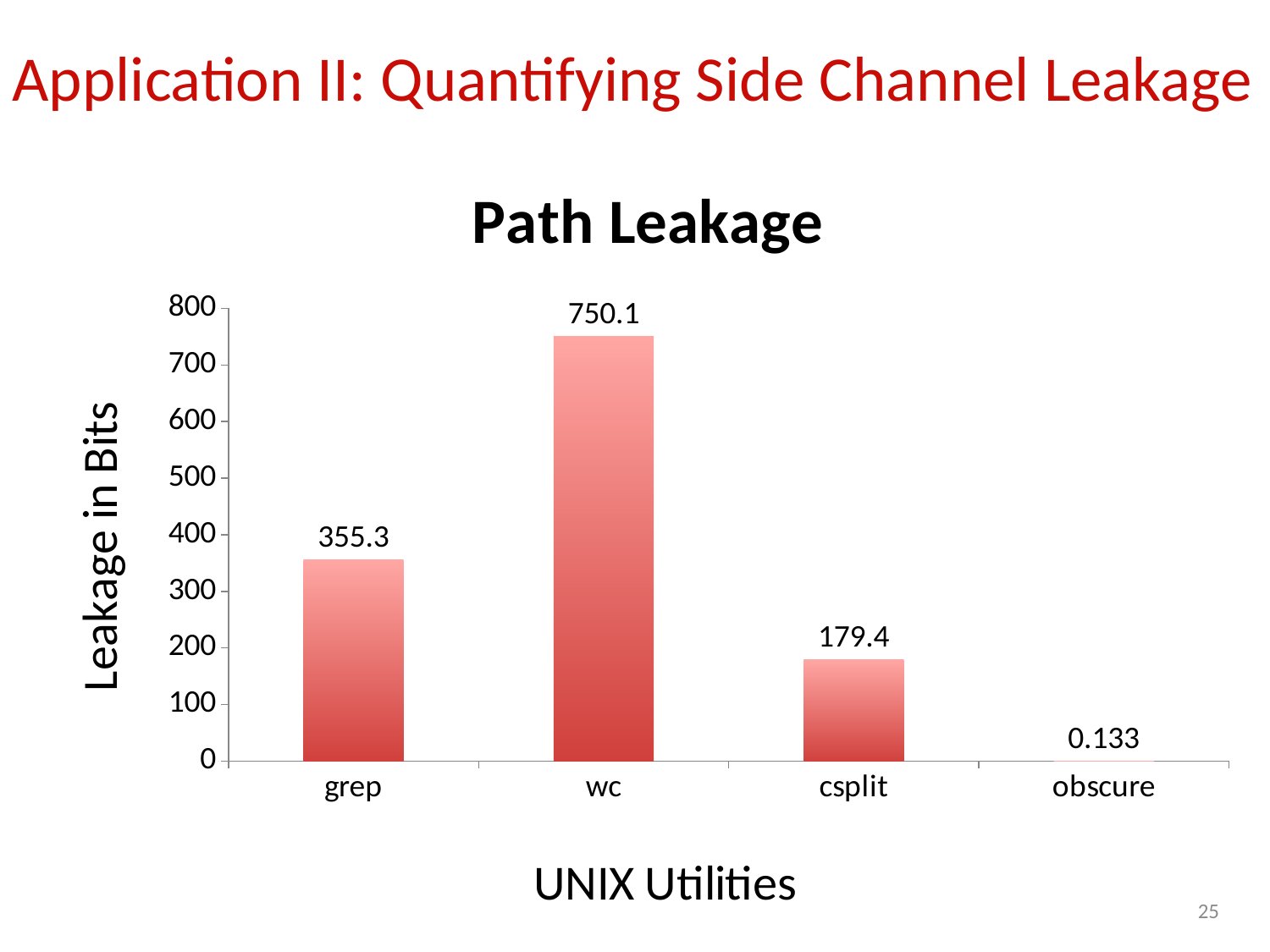
Is the value for csplit greater or less than 200? less How many UNIX utilities are shown on the x axis? 4 Which has a larger leakage value, grep or csplit? grep Which UNIX utility has the lowest path leakage? obscure What is the path leakage value for grep? 355.3 What kind of chart is shown on the slide? bar chart What is the path leakage value for csplit? 179.4 What is the label of the y axis? Leakage in Bits What is the path leakage value for wc? 750.1 What is the path leakage value for obscure? 0.133 Which UNIX utility has the highest path leakage? wc What is the difference in leakage between wc and grep? 394.8